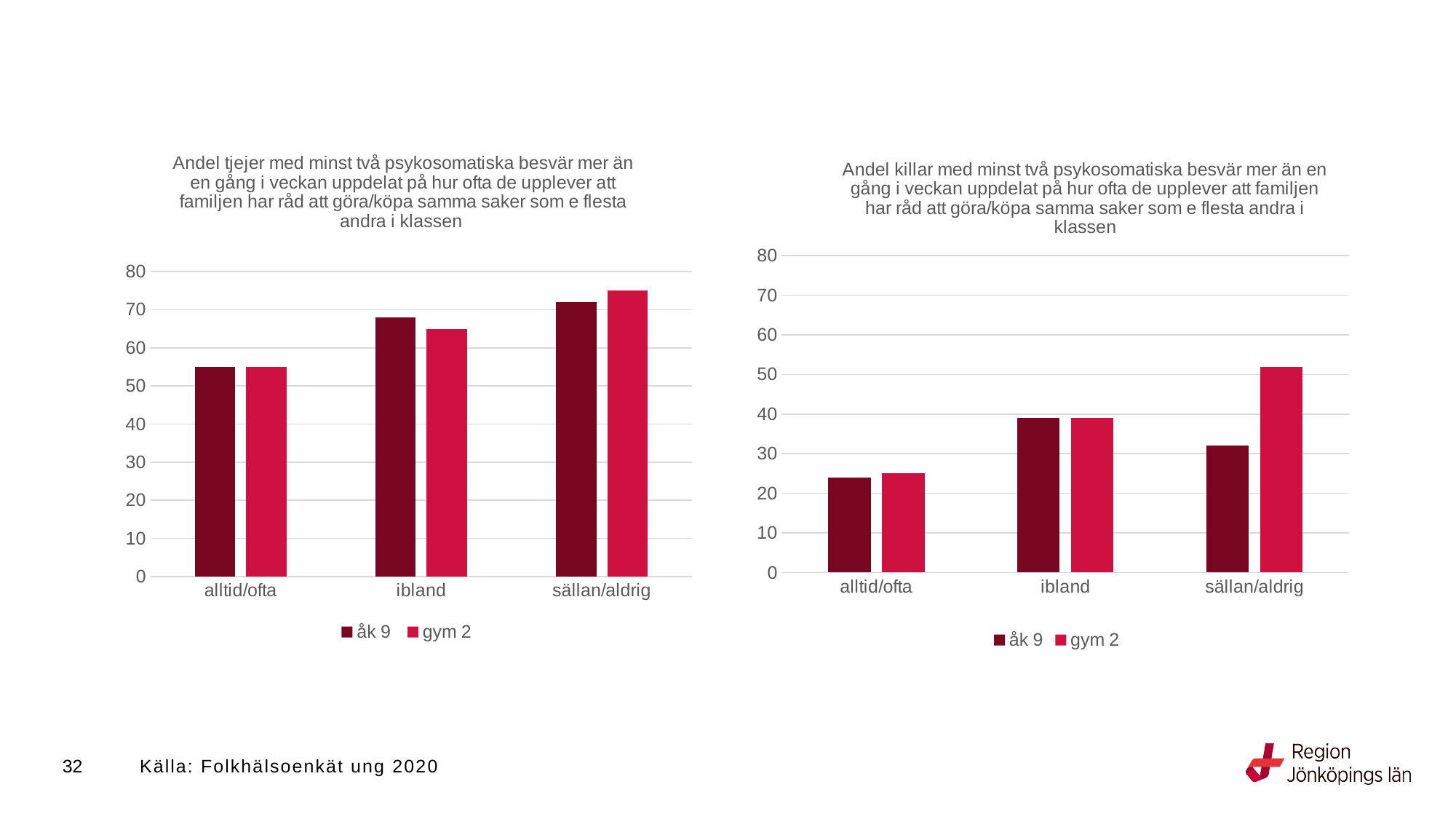
What kind of chart is the left chart about tjejer? bar chart In the left chart (tjejer), do the åk 9 values rise or fall from alltid/ofta to sällan/aldrig? rise In the right chart (killar), how many series does the legend list? 2 In the left chart (tjejer), is the value for åk 9 in the alltid/ofta category greater or less than 60? less In the left chart (tjejer), which category has the highest value for the gym 2 series? sällan/aldrig In the right chart (killar), which series has the higher value in the sällan/aldrig category, åk 9 or gym 2? gym 2 What are the two legend entries in the left chart (tjejer)? åk 9 and gym 2 In the right chart (killar), which category has the lowest value for the åk 9 series? alltid/ofta In the left chart (tjejer), is the value for gym 2 in the sällan/aldrig category greater or less than 70? greater In the left chart (tjejer), how many categories are shown on the x axis? 3 In the right chart (killar), is the value for gym 2 in the sällan/aldrig category greater or less than 40? greater